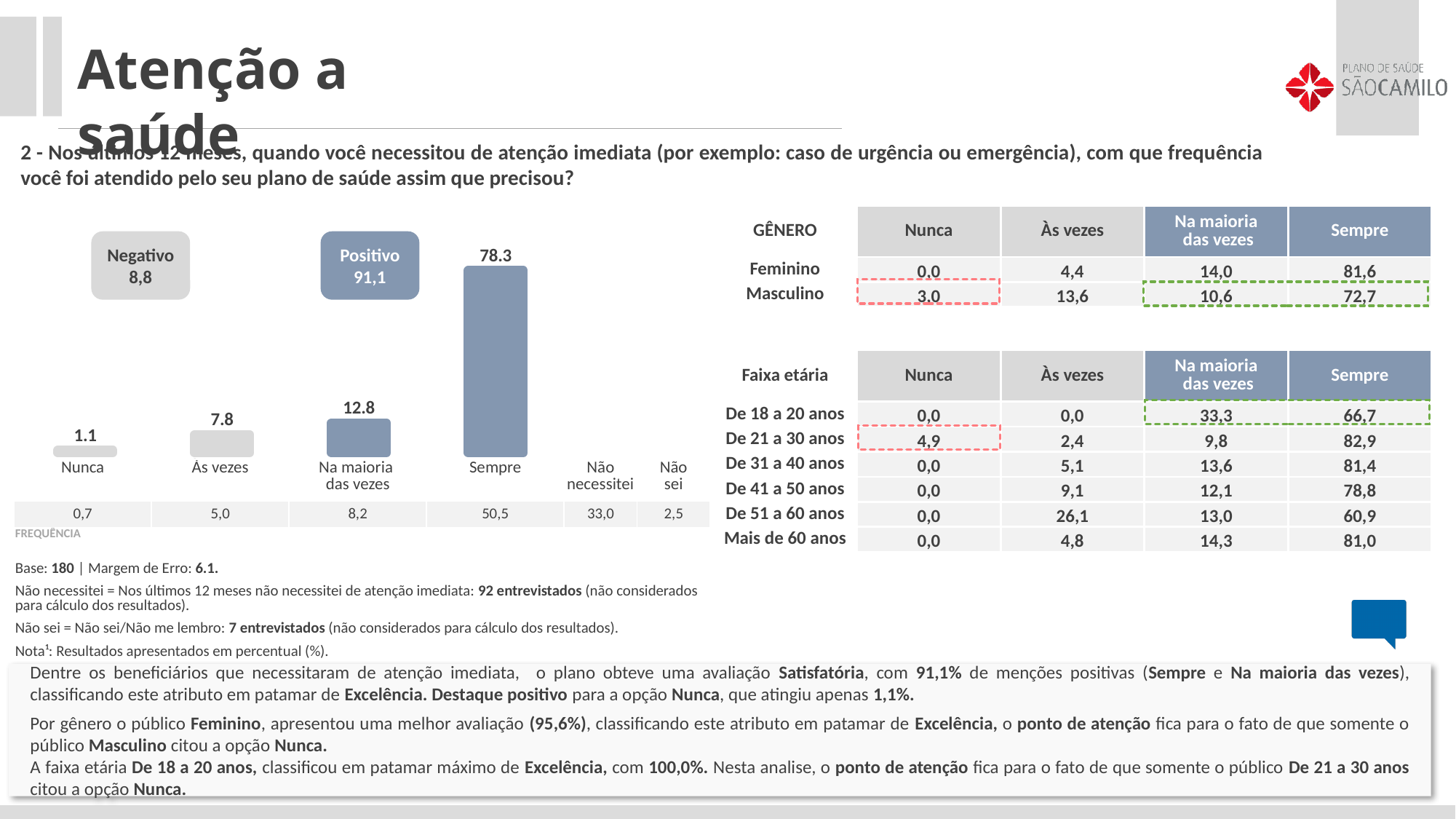
What kind of chart is shown on the slide? bar chart What is the value of the Nunca bar in the chart? 1.1 What is the value of the Na maioria das vezes bar in the chart? 12.8 What is the value of the Sempre bar in the chart? 78.3 How many bars are plotted in the chart? 4 What value is shown in the Positivo box above the chart? 91,1 Which category has the lowest bar in the chart? Nunca Which category has the highest bar in the chart? Sempre Do the bar values rise or fall from Nunca to Sempre along the x axis? rise What is the difference between the Sempre bar and the Na maioria das vezes bar? 65.5 What is the value of the Às vezes bar in the chart? 7.8 Which bar is larger, Às vezes or Na maioria das vezes? Na maioria das vezes